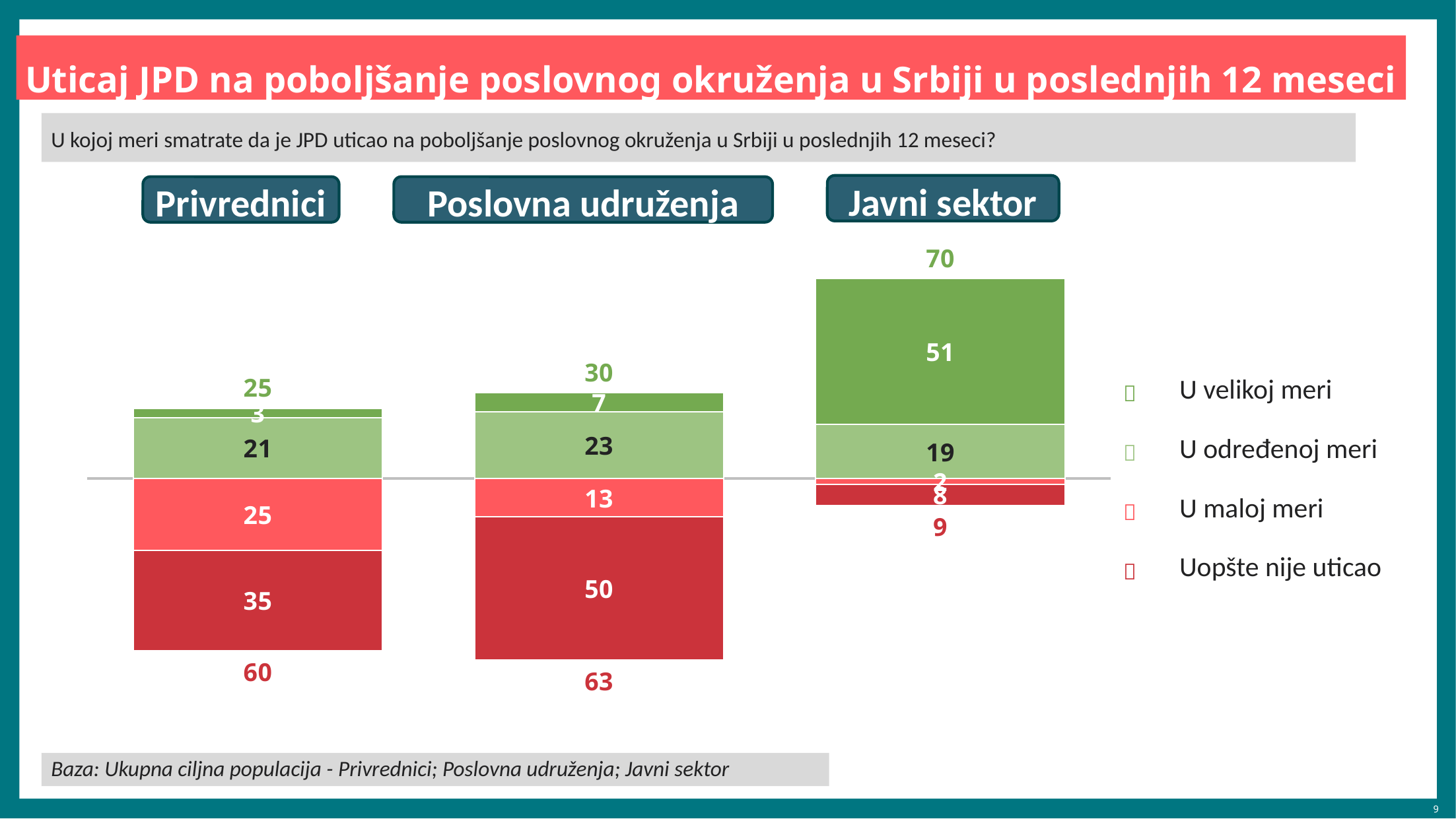
What is the difference between the "Uopšte nije uticao" values for Poslovna udruženja and Privrednici? 15 What is the value for "Uopšte nije uticao" in the Poslovna udruženja bar? 50 Which group has the highest value for "U velikoj meri"? Javni sektor Which group has the lowest value for "Uopšte nije uticao"? Javni sektor What is the combined negative total shown below the Privrednici bar? 60 How many groups (bars) are shown in the chart? 3 What is the value for "U maloj meri" in the Privrednici bar? 25 What is the value for "U određenoj meri" in the Privrednici bar? 21 What is the combined positive total (U velikoj meri plus U određenoj meri) shown above the Poslovna udruženja bar? 30 Which is larger: the "U određenoj meri" value for Poslovna udruženja or for Javni sektor? Poslovna udruženja What is the value for "U velikoj meri" in the Javni sektor bar? 51 How many series does the legend list? 4